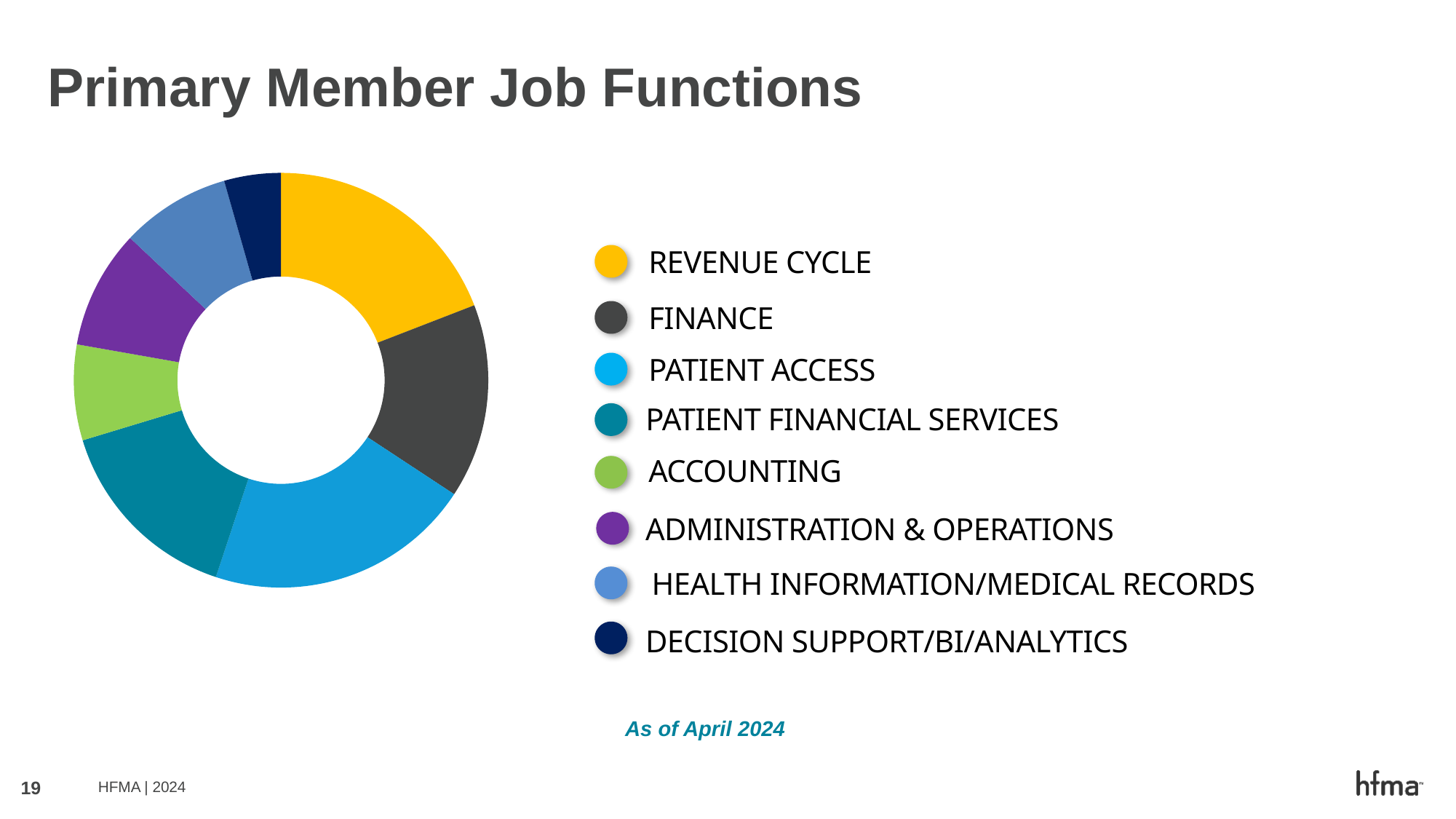
What is the title of the chart on the slide? Primary Member Job Functions Which job function is shown in yellow on the chart? Revenue Cycle Which job function has the smallest slice of the chart? Decision Support/BI/Analytics Which slice is larger, Accounting or Decision Support/BI/Analytics? Accounting What kind of chart is shown on the slide? Pie chart (donut) Which slice is larger, Finance or Administration & Operations? Finance Which slice is larger, Patient Access or Accounting? Patient Access How many job function categories does the chart show? 8